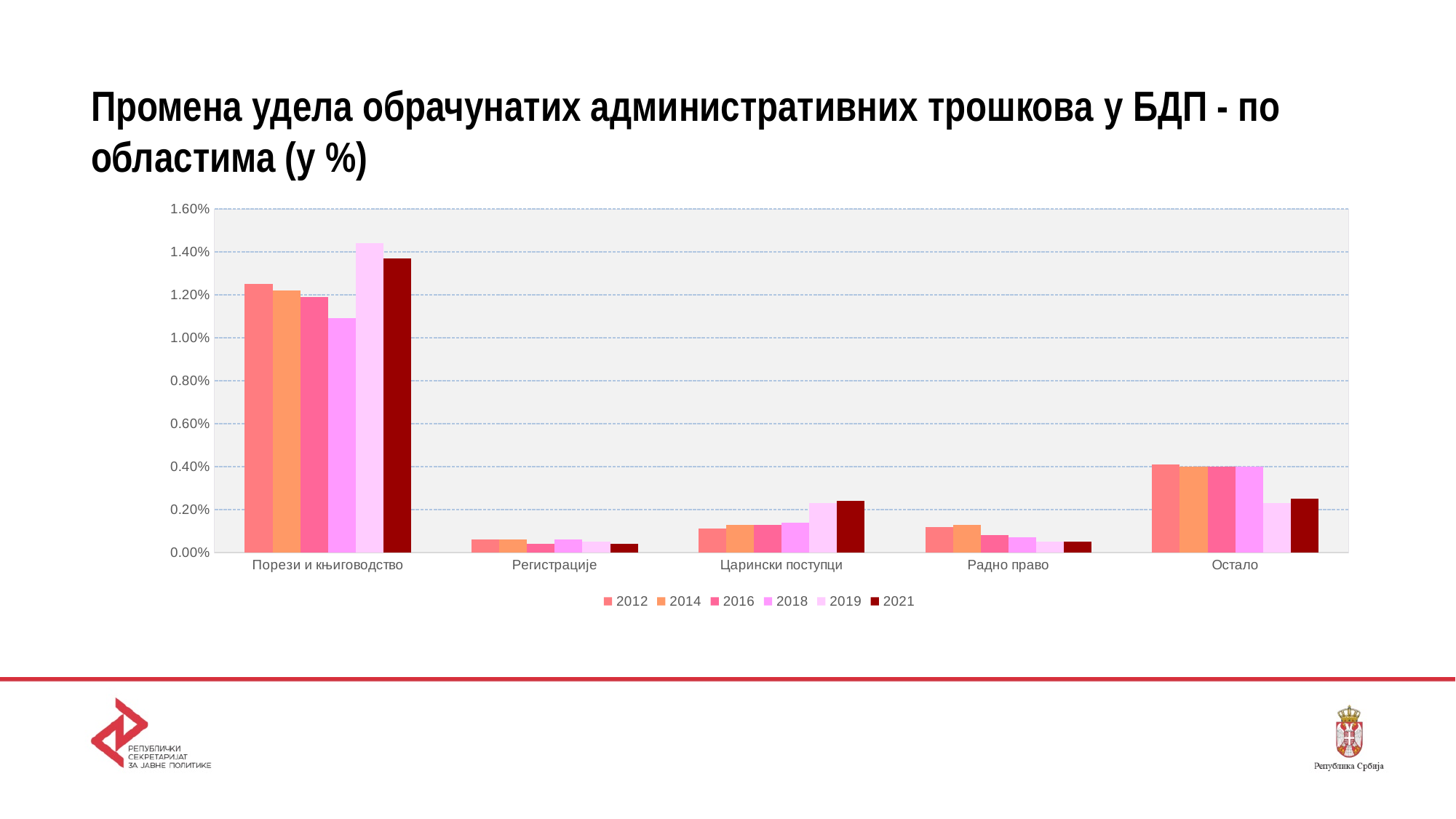
What kind of chart is shown on the slide? bar chart How many categories are shown on the x axis of the chart? 5 Do the values for Радно право rise or fall from 2012 to 2021? fall Is the 2018 value for Порези и књиговодство greater or less than 1.20%? less Is the 2012 value for Остало greater or less than 0.20%? greater Which category has the highest value for the 2019 series? Порези и књиговодство For Остало, which is larger: the 2012 value or the 2019 value? 2012 Do the values for Царински поступци rise or fall from 2012 to 2021? rise Which series has the lowest value for Порези и књиговодство? 2018 How many series does the legend list? 6 For Порези и књиговодство, which is larger: the 2019 value or the 2021 value? 2019 Is the 2021 value for Порези и књиговодство greater or less than 1.20%? greater